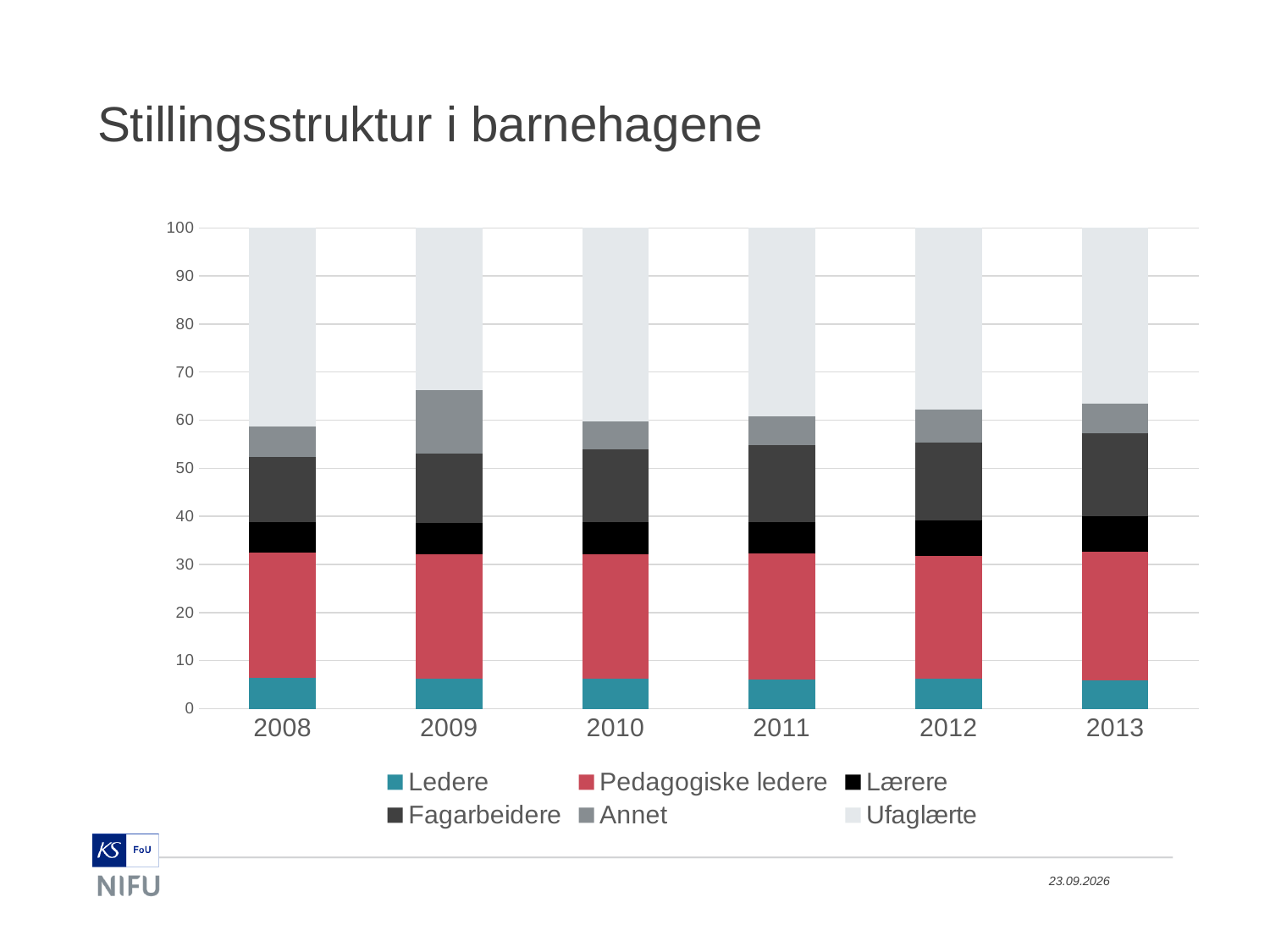
Is the Ufaglærte segment larger in 2008 or in 2009? 2008 Which series is plotted at the top of each stacked bar? Ufaglærte What is the total height of the stacked bar for 2008? 100 What is the title of the chart on the slide? Stillingsstruktur i barnehagene Is the top of the Annet segment in 2009 greater or less than 60? greater Is the top of the Pedagogiske ledere segment in 2010 greater or less than 30? greater Is the top of the Fagarbeidere segment in 2013 greater or less than 50? greater Which year has the largest Annet segment? 2009 How many series does the legend list? 6 How many years are shown on the x axis of the chart? 6 What kind of chart is shown on the slide? Stacked bar chart